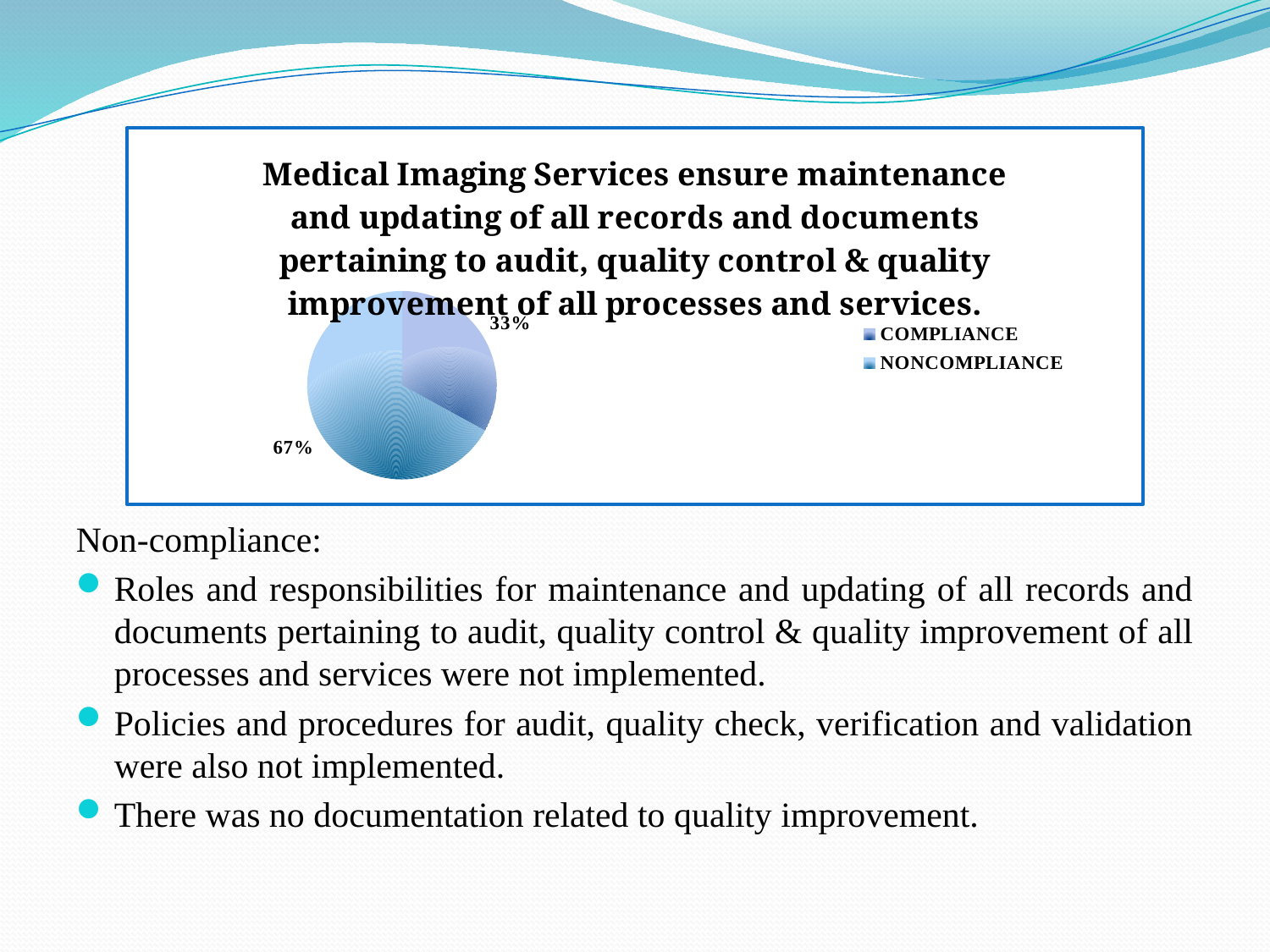
Which is larger in the pie chart, COMPLIANCE or NONCOMPLIANCE? NONCOMPLIANCE How many entries does the legend of the pie chart list? 2 Which slice of the pie chart is the largest? NONCOMPLIANCE What are the two legend entries of the pie chart? COMPLIANCE and NONCOMPLIANCE How many slices does the pie chart have? 2 What are the first four words of the chart's title? Medical Imaging Services ensure What share of the pie does the NONCOMPLIANCE slice represent? 67% What type of chart is shown on the slide? pie chart What is the difference in percentage points between the NONCOMPLIANCE and COMPLIANCE slices? 34 Which slice of the pie chart is the smallest? COMPLIANCE What percentage of the pie chart is labelled NONCOMPLIANCE? 67% What percentage of the pie chart is labelled COMPLIANCE? 33%